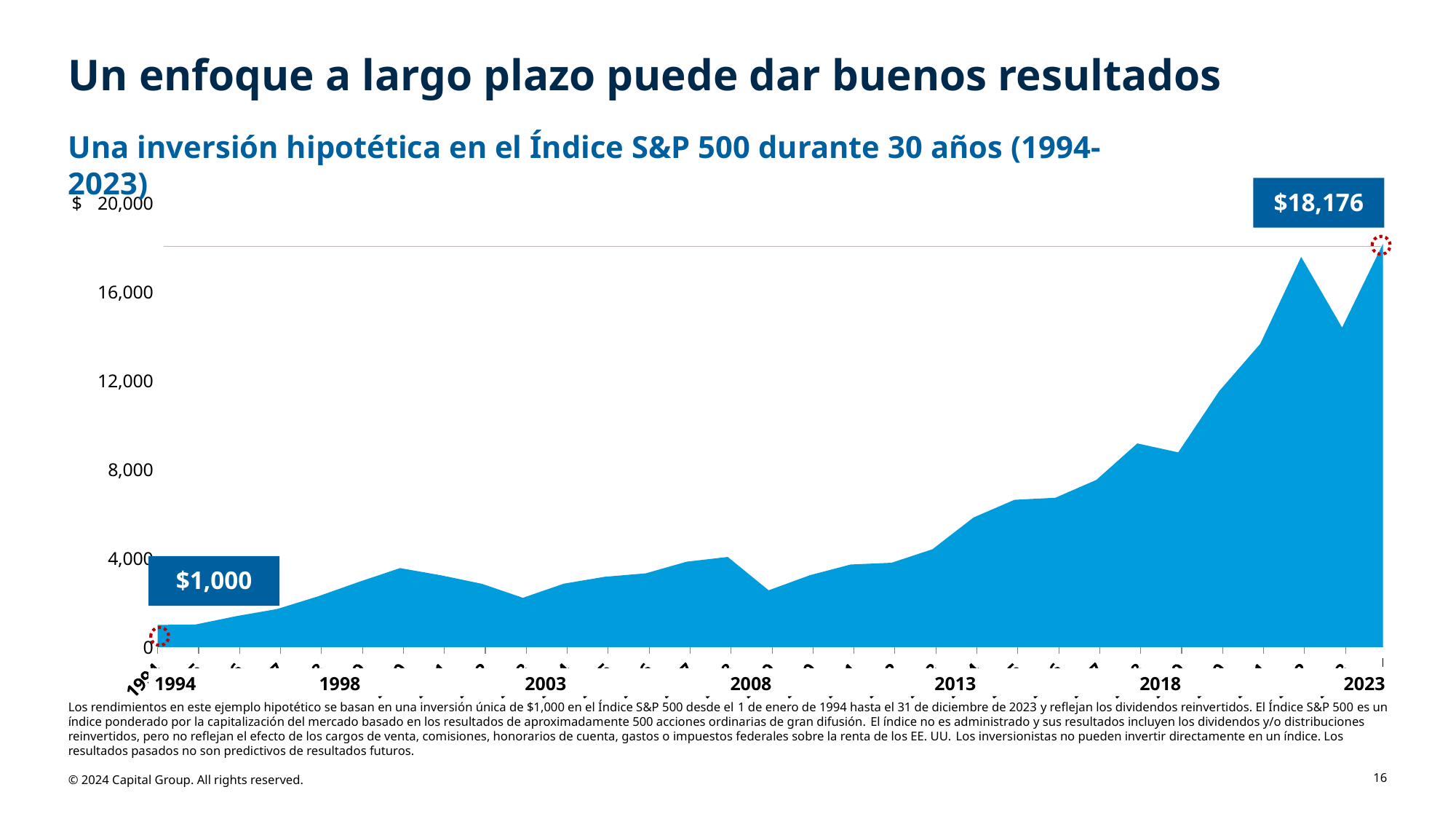
What kind of chart is shown on the slide? Area chart What is the initial investment value shown at the start of the chart in 1994? $1,000 Is the value for 2008 greater or less than 4,000? less Which year has the lowest value on the chart? 1994 Which is larger, the value for 2018 or the value for 2013? 2018 Is the value for 2003 greater or less than 4,000? less What is the value of the investment at the end of 2023 according to the data label? $18,176 What is the highest tick value shown on the y-axis? 20,000 By how much did the investment grow from the labeled starting value to the labeled 2023 value? $17,176 Is the value for 2018 greater or less than 8,000? greater How many years does the hypothetical investment period cover according to the chart subtitle? 30 Do the values generally rise or fall from 1994 to 2023? Rise